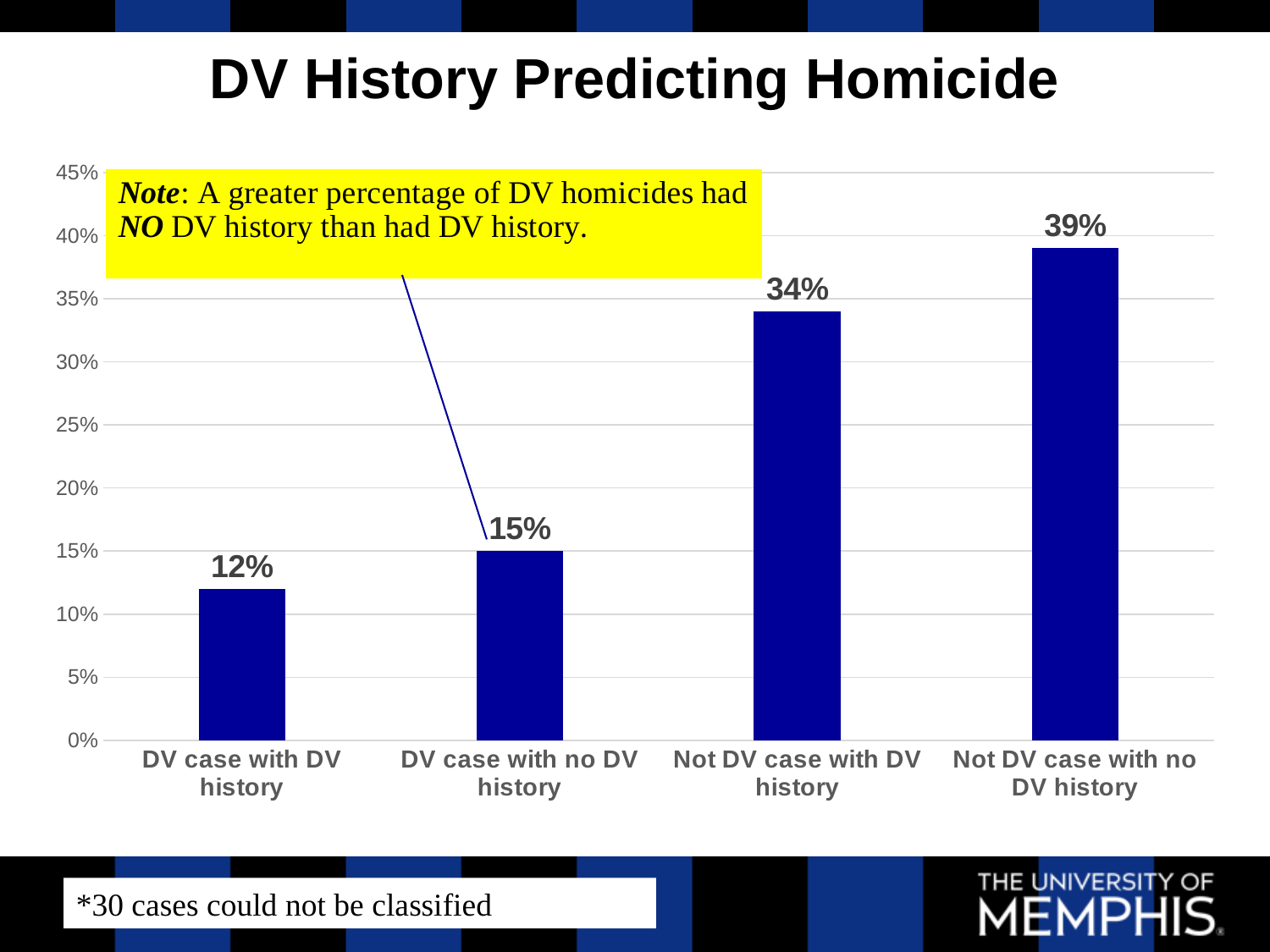
Which category has the lowest value? DV case with DV history What is the value for "Not DV case with no DV history"? 39% What is the title of the chart? DV History Predicting Homicide What is the value for "Not DV case with DV history"? 34% What is the difference between "DV case with no DV history" and "DV case with DV history"? 3% What is the value for "DV case with DV history"? 12% Is the value for "Not DV case with DV history" greater or less than 30%? greater Which is larger: "DV case with no DV history" or "DV case with DV history"? DV case with no DV history What kind of chart is shown on the slide? Bar chart Which category has the highest value? Not DV case with no DV history How many categories are shown on the chart? 4 What is the difference between "Not DV case with no DV history" and "Not DV case with DV history"? 5%